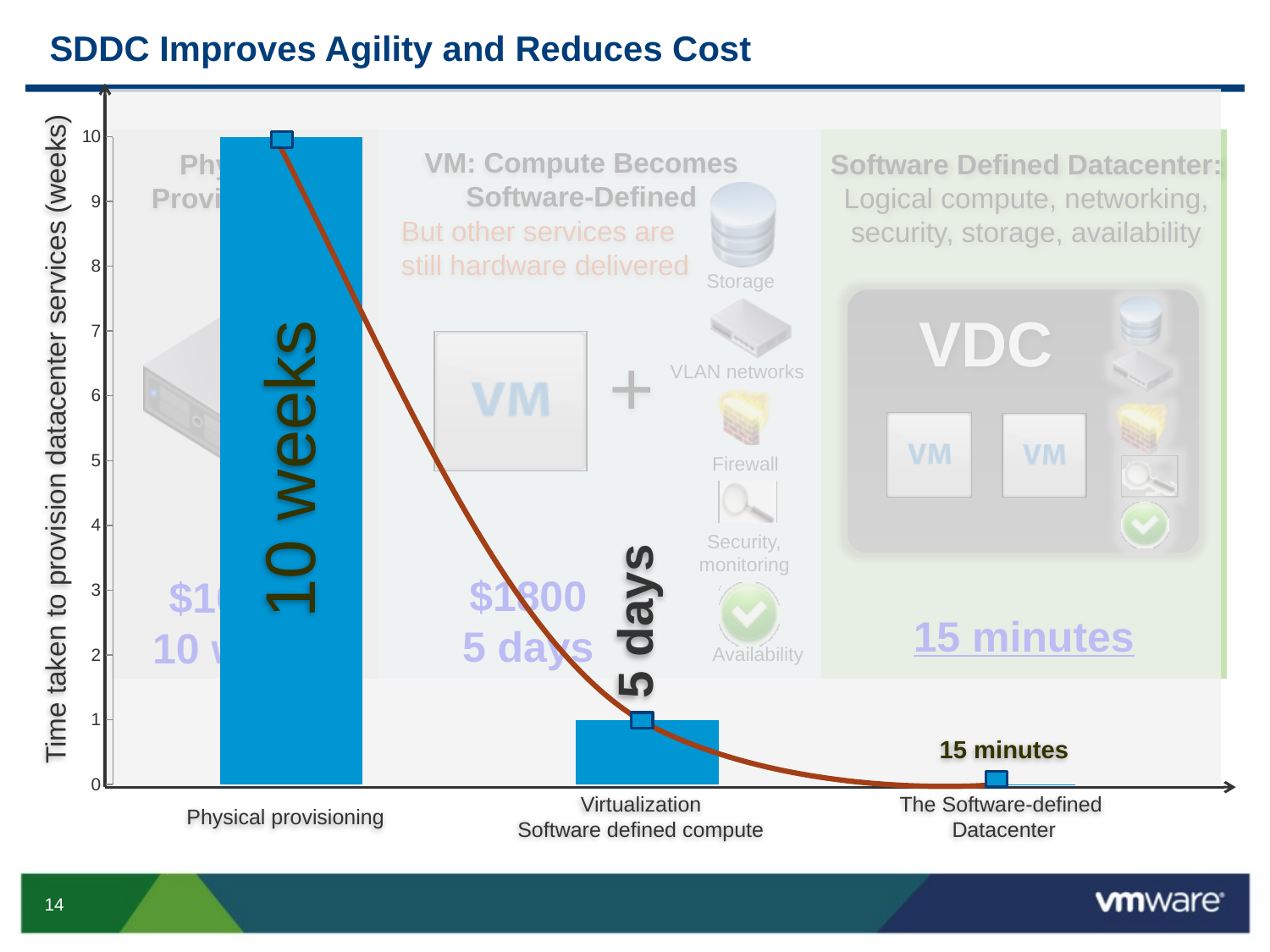
What is the label of the y axis? Time taken to provision datacenter services (weeks) Do the bar values rise or fall from left to right along the x axis? fall What is the data label on the bar for Physical provisioning? 10 weeks What kind of chart is this? bar chart What is the data label on the bar for Virtualization / Software defined compute? 5 days Is the value for Physical provisioning greater or less than 5 on the y axis? greater Which bar is taller: Physical provisioning or Virtualization / Software defined compute? Physical provisioning How many categories are shown on the x axis? 3 Which category has the tallest bar? Physical provisioning Is the value for Virtualization / Software defined compute greater or less than 2 on the y axis? less Which category has the shortest bar? The Software-defined Datacenter What is the data label for The Software-defined Datacenter? 15 minutes